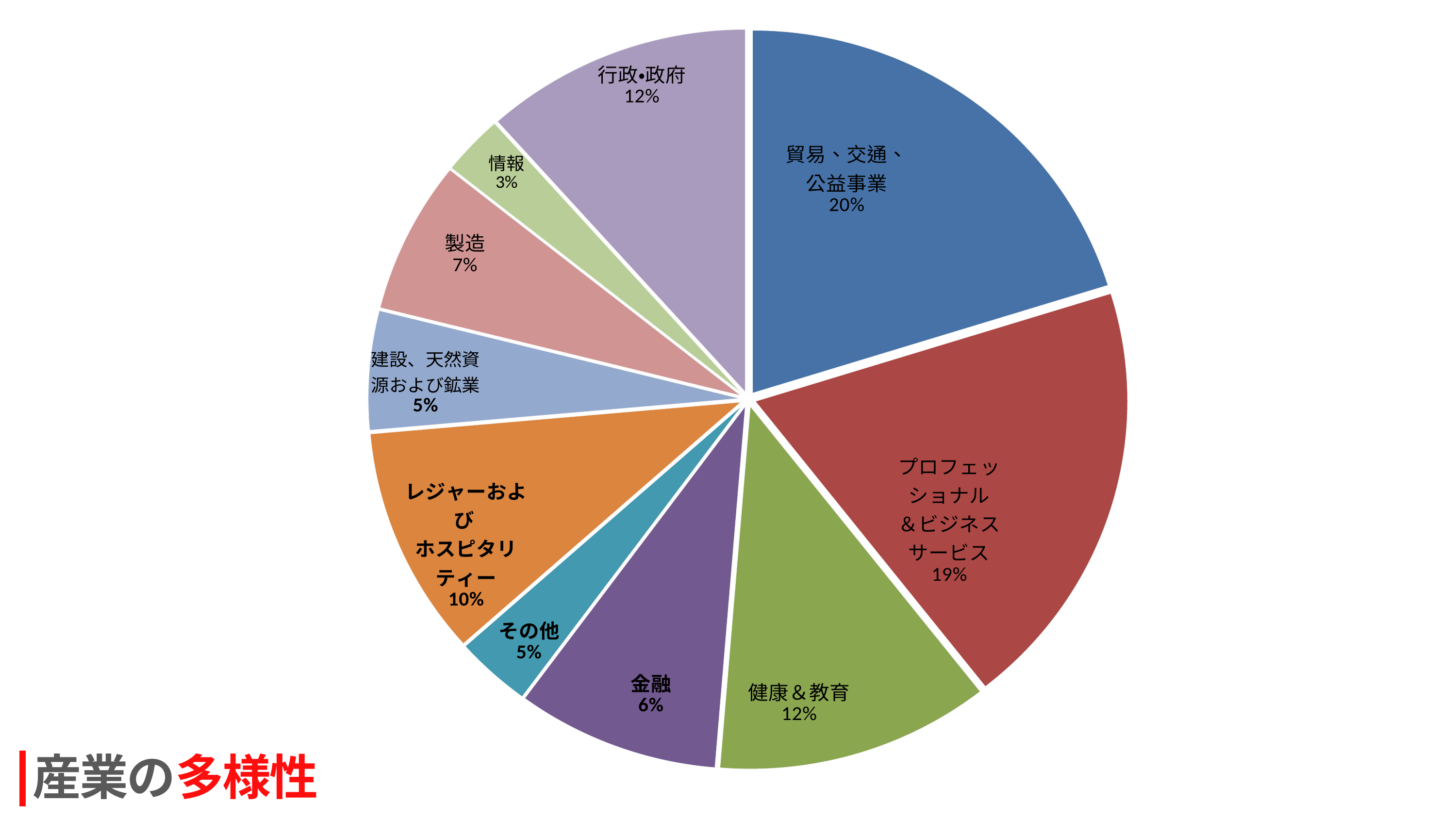
What is the title text shown at the bottom left of the slide? 産業の多様性 Which category has the smallest slice of the pie? 情報 Which category has the largest slice of the pie? 貿易、交通、公益事業 Which is larger, the value for 製造 or the value for その他? 製造 What share of the pie does 貿易、交通、公益事業 have? 20% What is the value shown for プロフェッショナル＆ビジネスサービス? 19% What is the value shown for レジャーおよびホスピタリティー? 10% What is the value shown for 金融? 6% How many slices does the pie chart have? 10 What is the value shown for 製造? 7% What kind of chart is shown on the slide? Pie chart What is the difference between the values for 健康＆教育 and 情報? 9%